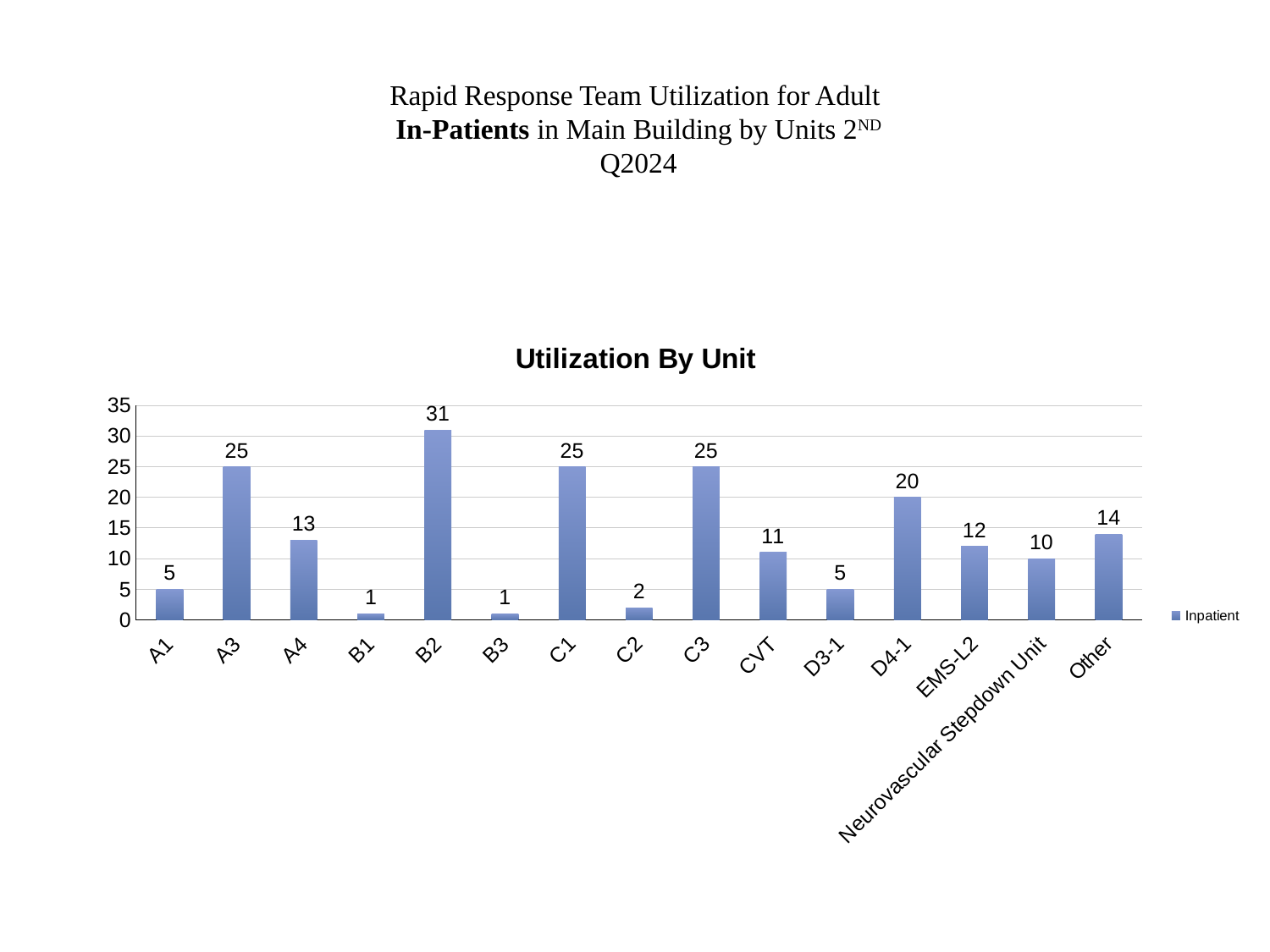
How many series does the legend list? 1 What is the difference between the values for B2 and D4-1? 11 What is the value for B2? 31 What is the title of the chart? Utilization By Unit What kind of chart is shown? bar chart Is the value for A4 greater or less than 10? greater How many units are shown on the x axis? 15 What is the value for EMS-L2? 12 What is the value for Neurovascular Stepdown Unit? 10 Which unit has the highest value? B2 Which is larger, the value for CVT or the value for Other? Other What series name is shown in the legend? Inpatient